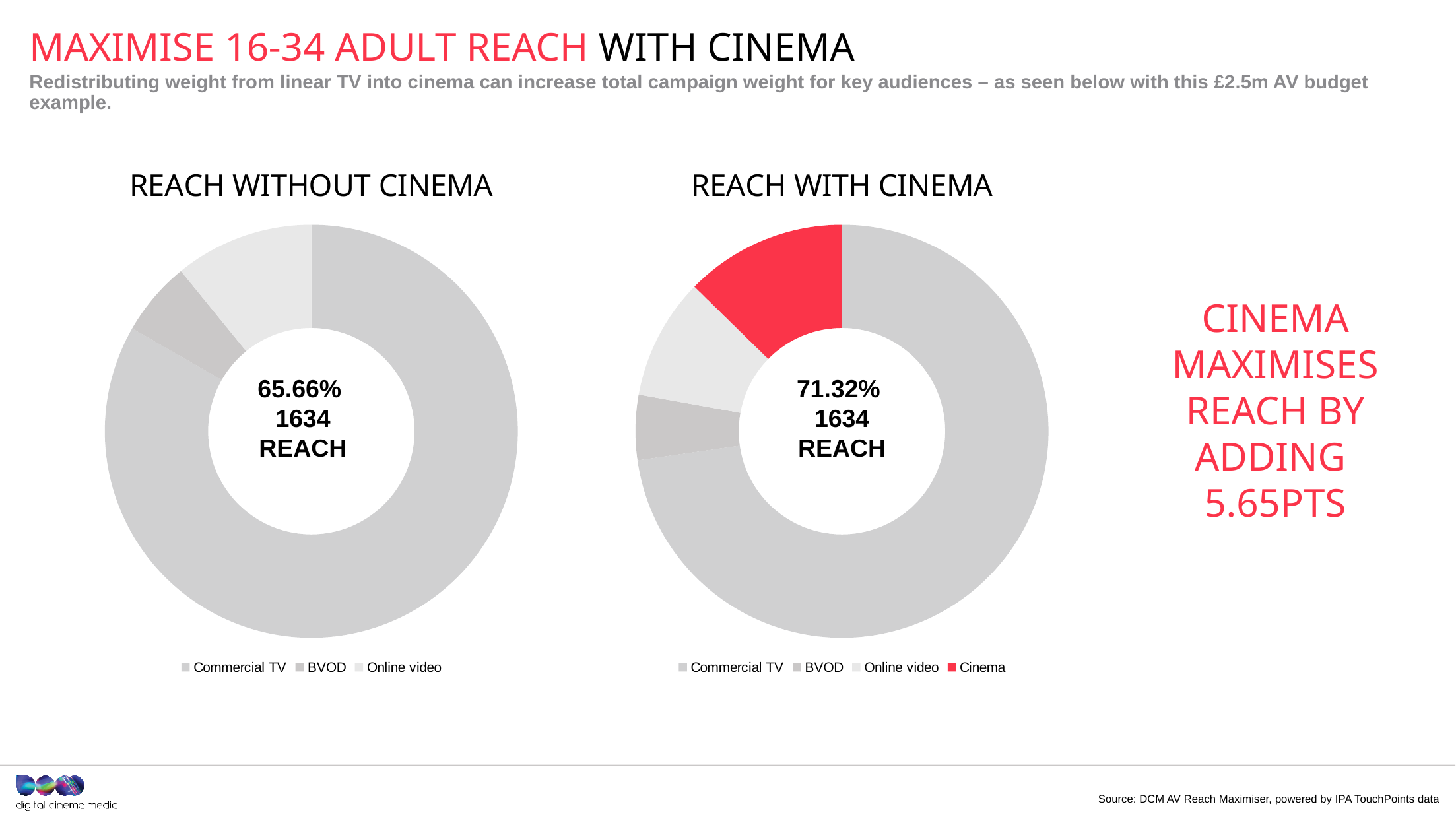
What kind of chart is the 'REACH WITHOUT CINEMA' chart? Pie chart (donut) In the 'REACH WITH CINEMA' chart, which category has the largest slice? Commercial TV In the 'REACH WITH CINEMA' chart, what reach percentage is shown in the centre? 71.32% In the 'REACH WITHOUT CINEMA' chart, what reach percentage is shown in the centre? 65.66% How many categories does the legend of the 'REACH WITHOUT CINEMA' chart list? 3 Which chart shows the higher reach percentage, 'REACH WITHOUT CINEMA' or 'REACH WITH CINEMA'? REACH WITH CINEMA In the 'REACH WITHOUT CINEMA' chart, which category has the largest slice? Commercial TV In the 'REACH WITH CINEMA' chart, what colour is the Cinema slice? Red Is the reach percentage in the 'REACH WITHOUT CINEMA' chart greater or less than 70%? less How many categories does the legend of the 'REACH WITH CINEMA' chart list? 4 Which category appears in the legend of the 'REACH WITH CINEMA' chart but not in the 'REACH WITHOUT CINEMA' chart? Cinema In the 'REACH WITH CINEMA' chart, which category has the smallest slice? BVOD